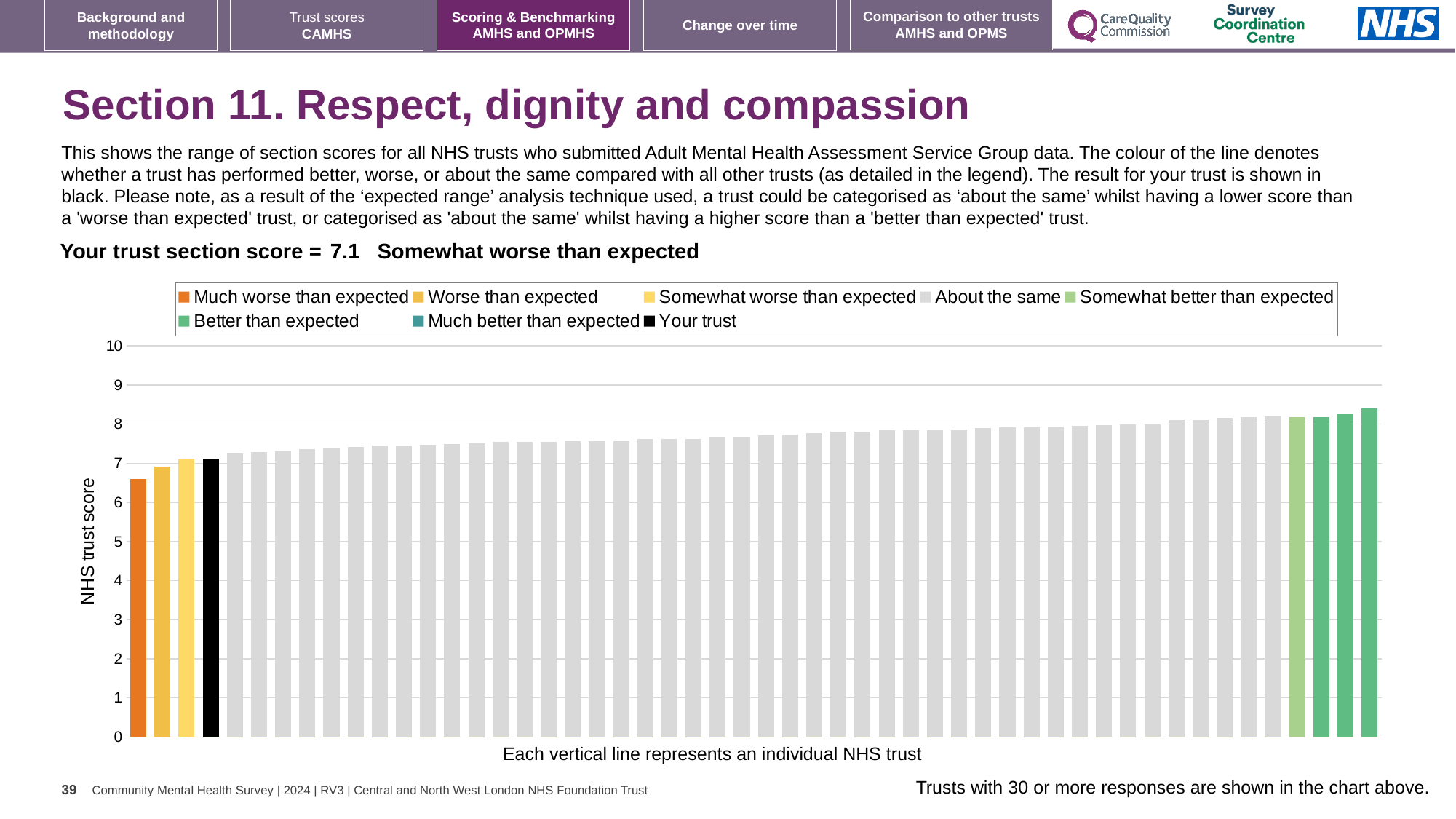
What is the label on the y axis of the chart? NHS trust score Is the value of the lowest bar (the leftmost orange bar) greater or less than 7? less Is the value for your trust greater or less than 6? greater What kind of chart is shown on the slide? bar chart What colour is the bar for your trust? black Do the bar values rise or fall from left to right along the x axis? rise Is the value of the highest bar (the rightmost green bar) greater or less than 8? greater Which is larger: the value of the leftmost bar or the value of the rightmost bar? the rightmost bar What is the section score for your trust? 7.1 How many entries does the chart legend list? 8 Which category does your trust fall into according to the slide? Somewhat worse than expected